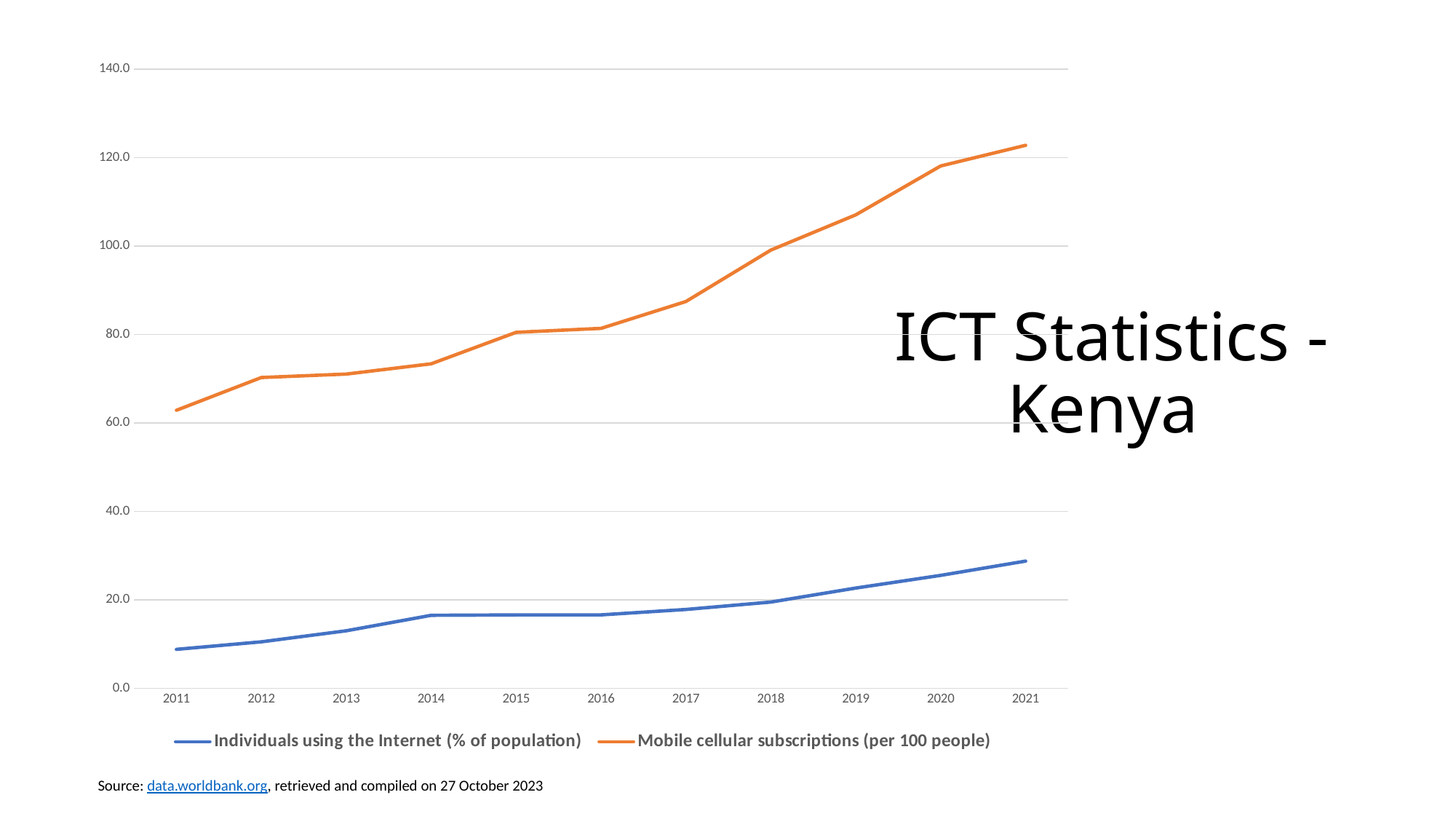
Does the value for Mobile cellular subscriptions (per 100 people) rise or fall from 2011 to 2021? Rise How many years are plotted along the x axis? 11 Is the value for Individuals using the Internet (% of population) in 2014 greater or less than 20? less What is the title shown on the slide? ICT Statistics - Kenya Is the value for Individuals using the Internet (% of population) in 2021 greater or less than 40? less Is the value for Mobile cellular subscriptions (per 100 people) in 2021 greater or less than 120? greater How many series does the legend list? 2 In which year is the value for Mobile cellular subscriptions (per 100 people) highest? 2021 What kind of chart is shown on the slide? Line chart In which year is the value for Individuals using the Internet (% of population) lowest? 2011 Which series has the larger value in 2021, Individuals using the Internet or Mobile cellular subscriptions? Mobile cellular subscriptions (per 100 people)